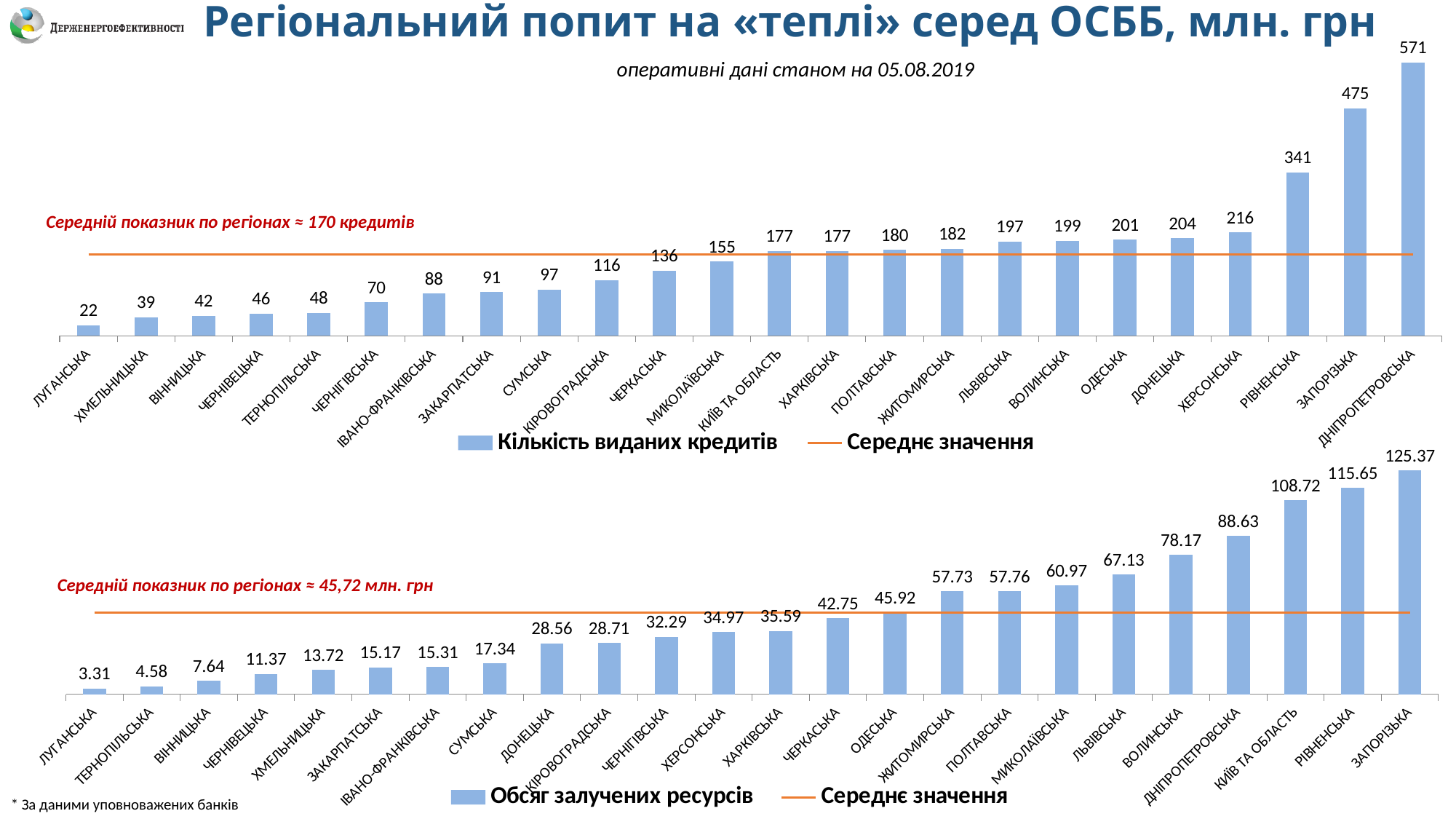
In the bottom chart, what is the average value across regions stated on the slide? ≈ 45,72 млн. грн In the top chart (Кількість виданих кредитів), what is the difference between Запорізька and Рівненська? 134 In the bottom chart (Обсяг залучених ресурсів), what is the value for Одеська? 45.92 In the top chart (Кількість виданих кредитів), what is the value for Київ та область? 177 What kind of chart is the top chart? Bar chart In the bottom chart (Обсяг залучених ресурсів), which region has the highest value? Запорізька In the bottom chart (Обсяг залучених ресурсів), what is the value for Запорізька? 125.37 In the bottom chart (Обсяг залучених ресурсів), which is larger, Львівська or Волинська? Волинська In the top chart (Кількість виданих кредитів), what is the value for Дніпропетровська? 571 In the bottom chart (Обсяг залучених ресурсів), what is the difference between Київ та область and Дніпропетровська? 20.09 In the top chart (Кількість виданих кредитів), how many regions are shown? 24 In the top chart (Кількість виданих кредитів), which region has the lowest value? Луганська